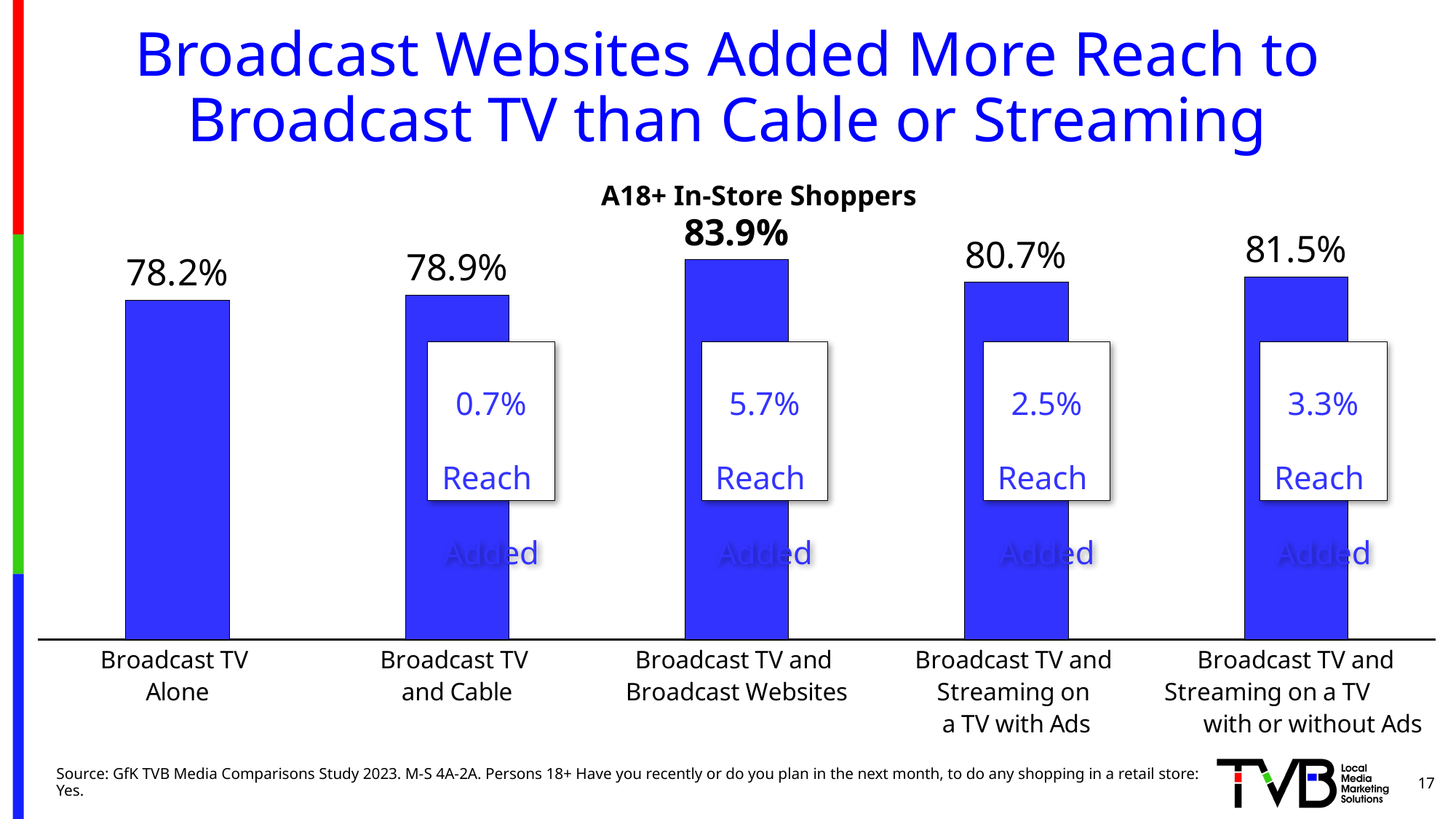
What is the subtitle shown above the chart? A18+ In-Store Shoppers What is the difference in reach between Broadcast TV and Broadcast Websites and Broadcast TV Alone? 5.7% What is the reach value for Broadcast TV and Streaming on a TV with Ads? 80.7% What is the reach value for Broadcast TV and Broadcast Websites? 83.9% Which category has the highest reach? Broadcast TV and Broadcast Websites What is the reach value for Broadcast TV and Streaming on a TV with or without Ads? 81.5% Which category has the lowest reach? Broadcast TV Alone What is the difference in reach between Broadcast TV and Cable and Broadcast TV Alone? 0.7% What kind of chart is shown on the slide? Bar chart Which has a larger reach: Broadcast TV and Cable or Broadcast TV and Streaming on a TV with Ads? Broadcast TV and Streaming on a TV with Ads How many categories are shown in the chart? 5 What is the reach value for Broadcast TV Alone? 78.2%